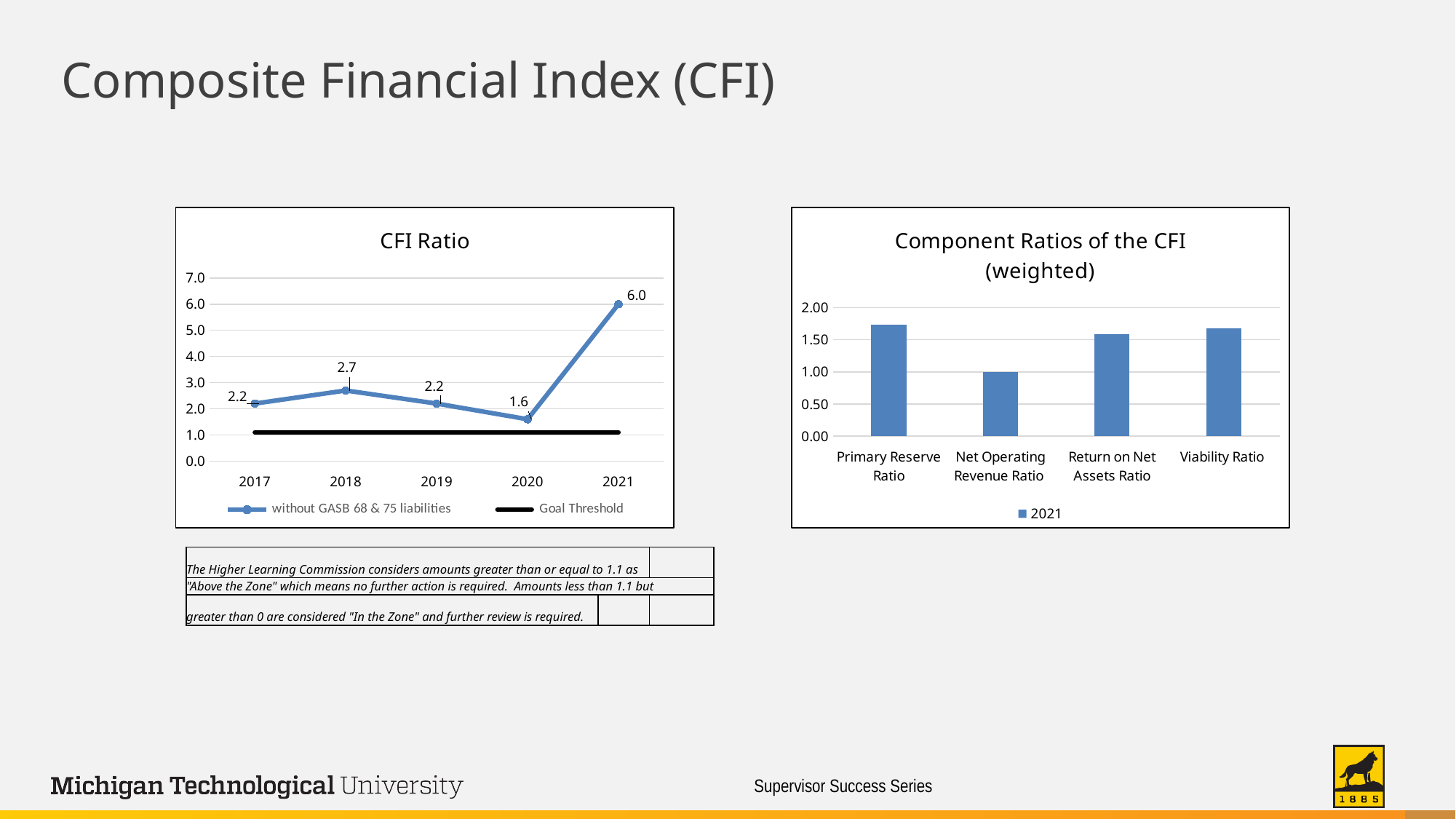
In the Component Ratios of the CFI (weighted) chart, which category has the lowest value? Net Operating Revenue Ratio In the CFI Ratio chart, which is larger, the value for 2018 or the value for 2019? 2018 In the CFI Ratio chart, what is the value for 2018? 2.7 In the CFI Ratio chart, which year has the highest value? 2021 In the CFI Ratio chart, what is the difference between the 2021 value and the 2020 value? 4.4 In the Component Ratios of the CFI (weighted) chart, is the value for Net Operating Revenue Ratio greater or less than 1.50? less What kind of chart is the Component Ratios of the CFI (weighted) chart? bar chart In the CFI Ratio chart, what is the value for 2021? 6.0 In the CFI Ratio chart, how many series does the legend list? 2 In the Component Ratios of the CFI (weighted) chart, how many categories are shown? 4 In the CFI Ratio chart, which year has the lowest value? 2020 In the CFI Ratio chart, how many years are plotted on the x axis? 5